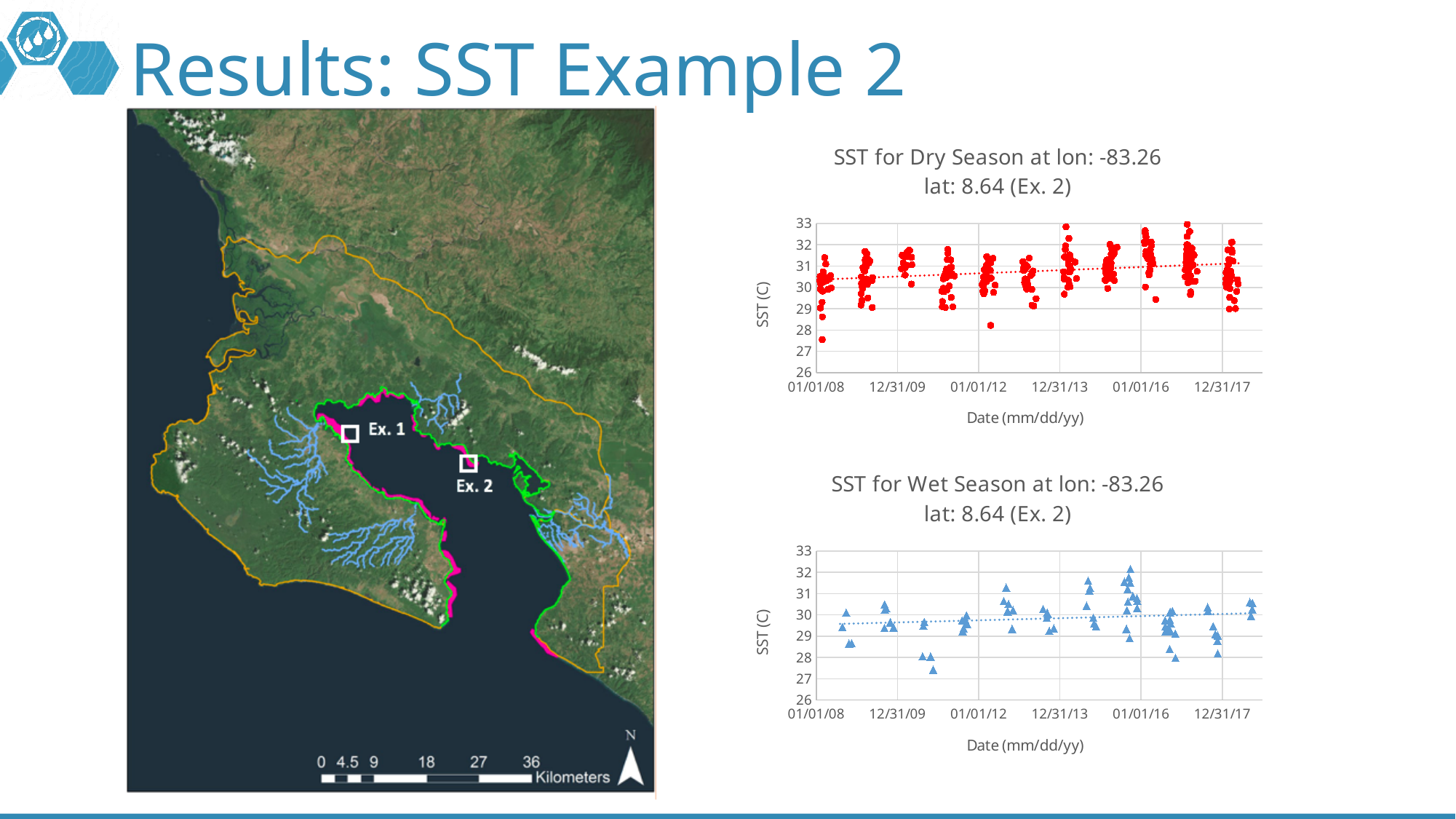
What is the y-axis label on the 'SST for Dry Season' chart? SST (C) In the 'SST for Dry Season' chart, does the dotted trend line rise or fall from left to right? rise What kind of chart is the 'SST for Wet Season' chart? scatter chart How many date tick labels are shown on the x axis of the 'SST for Wet Season' chart? 6 In the 'SST for Wet Season' chart, does the dotted trend line rise or fall from left to right? rise In the 'SST for Wet Season' chart, is the highest plotted value greater or less than 31? greater What is the x-axis label on the 'SST for Wet Season' chart? Date (mm/dd/yy) In the 'SST for Dry Season' chart, is the highest plotted value greater or less than 32? greater What kind of chart is the 'SST for Dry Season' chart? scatter chart Which chart reaches a higher maximum SST value, the Dry Season chart or the Wet Season chart? Dry Season chart In the 'SST for Dry Season' chart, is the lowest plotted value greater or less than 28? less